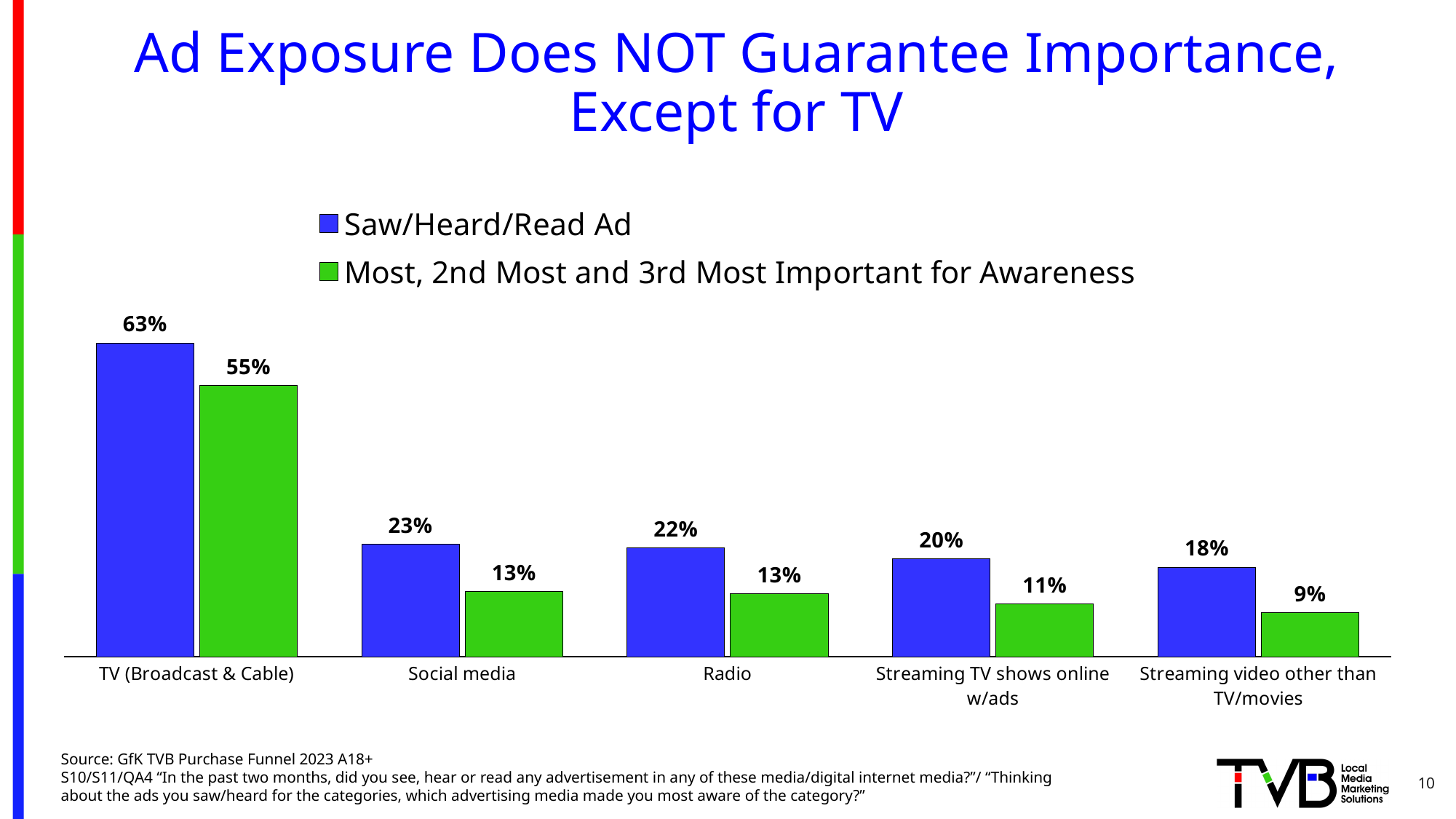
How many series does the legend list? 2 What is the Most, 2nd Most and 3rd Most Important for Awareness value for Radio? 13% What is the difference between the Saw/Heard/Read Ad values for TV (Broadcast & Cable) and Radio? 41% Which category has the lowest Most, 2nd Most and 3rd Most Important for Awareness value? Streaming video other than TV/movies What kind of chart is shown on the slide? Bar chart What is the Saw/Heard/Read Ad value for TV (Broadcast & Cable)? 63% Which category has the highest Saw/Heard/Read Ad value? TV (Broadcast & Cable) What is the Saw/Heard/Read Ad value for Streaming video other than TV/movies? 18% Which is larger: the Saw/Heard/Read Ad value for Social media or for Streaming TV shows online w/ads? Social media What colour represents the Saw/Heard/Read Ad series? Blue What is the difference between the Saw/Heard/Read Ad value and the Most, 2nd Most and 3rd Most Important for Awareness value for Social media? 10% How many categories are shown on the x axis? 5